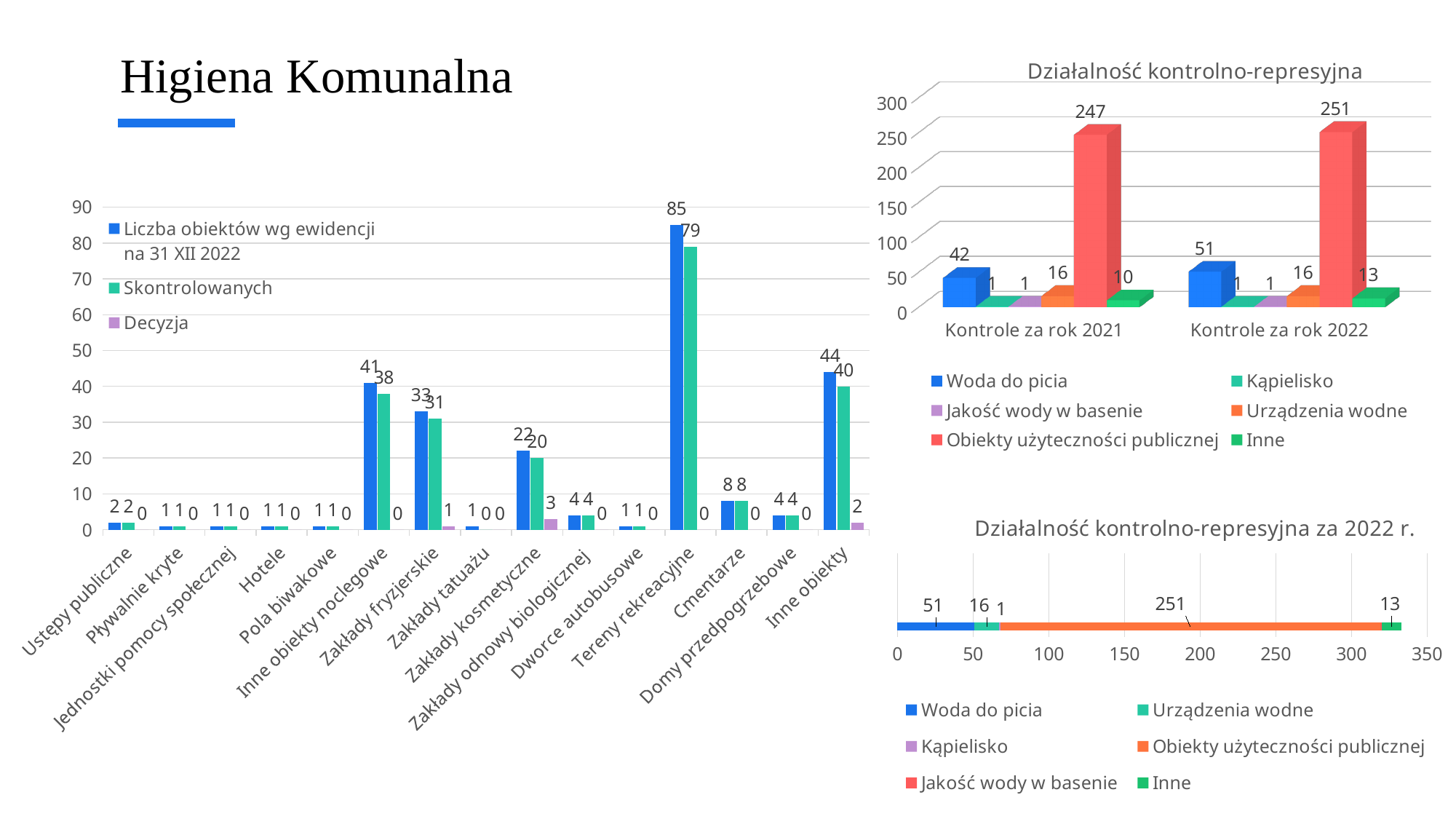
In the left chart, what is the value of 'Liczba obiektów wg ewidencji na 31 XII 2022' for Tereny rekreacyjne? 85 In the chart titled 'Działalność kontrolno-represyjna', how many series does the legend list? 6 In the left chart, which category has the highest 'Skontrolowanych' value? Tereny rekreacyjne In the left chart, how many series does the legend list? 3 In the left chart, what is the difference between the 'Liczba obiektów wg ewidencji' and 'Skontrolowanych' values for Zakłady kosmetyczne? 2 In the chart titled 'Działalność kontrolno-represyjna', what is the difference in 'Woda do picia' between Kontrole za rok 2022 and Kontrole za rok 2021? 9 In the chart titled 'Działalność kontrolno-represyjna', what is the value of 'Obiekty użyteczności publicznej' for Kontrole za rok 2022? 251 What kind of chart is 'Działalność kontrolno-represyjna za 2022 r.'? Stacked bar chart In the left chart, what is the 'Skontrolowanych' value for Inne obiekty noclegowe? 38 In the left chart, what is the 'Decyzja' value for Zakłady kosmetyczne? 3 In the left chart, how many categories are shown on the x axis? 15 In the chart titled 'Działalność kontrolno-represyjna', is 'Inne' larger for Kontrole za rok 2021 or Kontrole za rok 2022? Kontrole za rok 2022